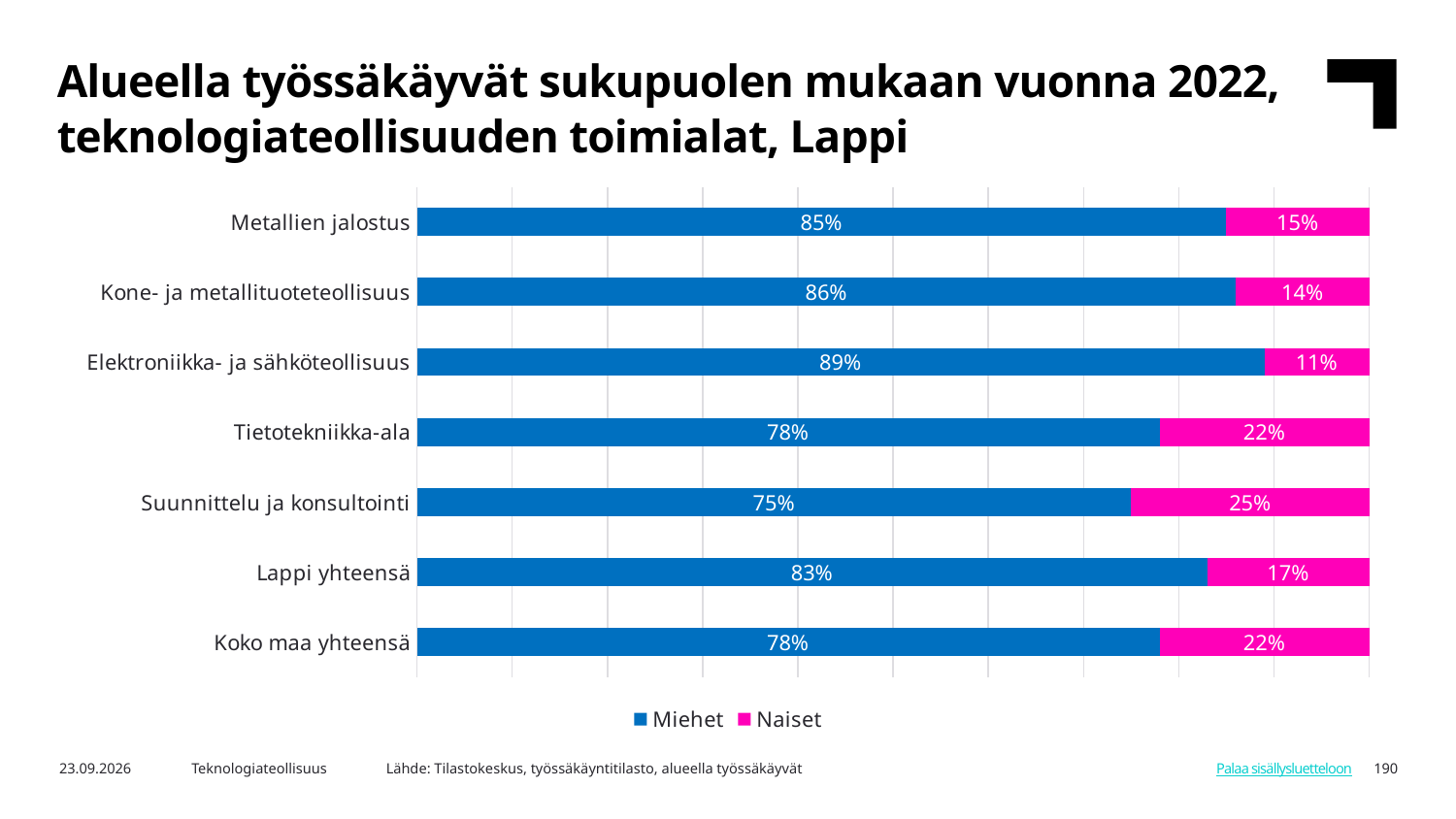
How many series does the legend list? 2 What is the difference between the Naiset share for Tietotekniikka-ala and the Naiset share for Elektroniikka- ja sähköteollisuus? 11% Which category has the highest Miehet share? Elektroniikka- ja sähköteollisuus What is the Naiset share for Suunnittelu ja konsultointi? 25% Which is larger: the Miehet share for Kone- ja metallituoteteollisuus or the Miehet share for Lappi yhteensä? Kone- ja metallituoteteollisuus What is the total of the stacked bar for Koko maa yhteensä? 100% How many categories are shown on the chart? 7 Which category has the lowest Miehet share? Suunnittelu ja konsultointi What is the Miehet share for Metallien jalostus? 85% Which series is shown in pink? Naiset What kind of chart is shown on the slide? Stacked bar chart What is the Naiset share for Lappi yhteensä? 17%